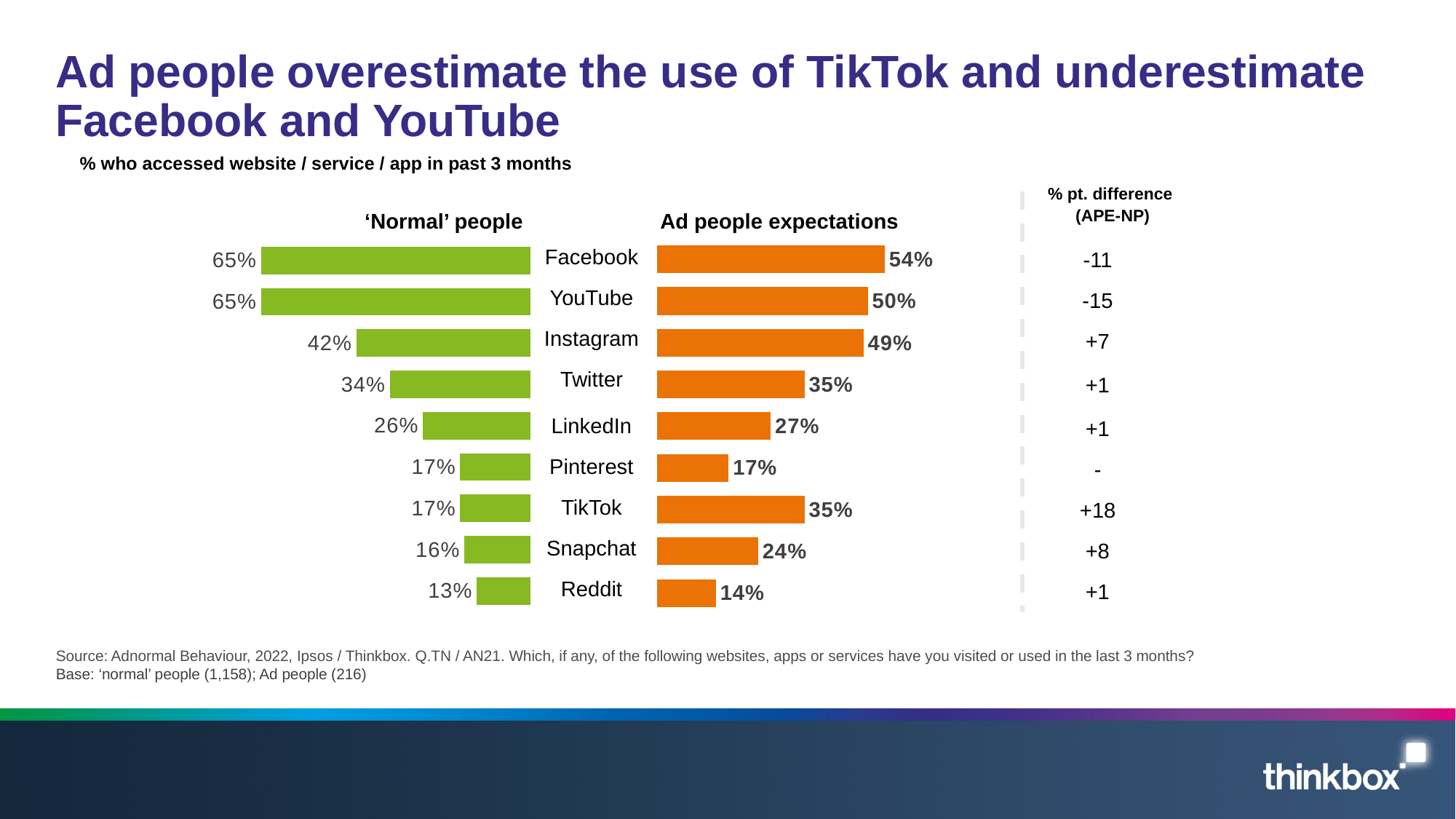
Which is larger for YouTube: the 'Normal' people value or the Ad people expectation? 'Normal' people What percentage of 'Normal' people accessed Facebook in the past 3 months? 65% Which is larger for Instagram: the 'Normal' people value or the Ad people expectation? Ad people expectations Which platform has the lowest value among 'Normal' people? Reddit What is the % pt. difference (APE-NP) shown for YouTube? -15 What colour are the bars for 'Normal' people? Green What is the Ad people expectation for Snapchat? 24% How many platforms are shown in the chart? 9 What is the Ad people expectation for TikTok? 35% What is the difference between the Ad people expectation and the 'Normal' people value for TikTok? 18 What type of chart is used on this slide? Bar chart Which platform has the highest Ad people expectation? Facebook